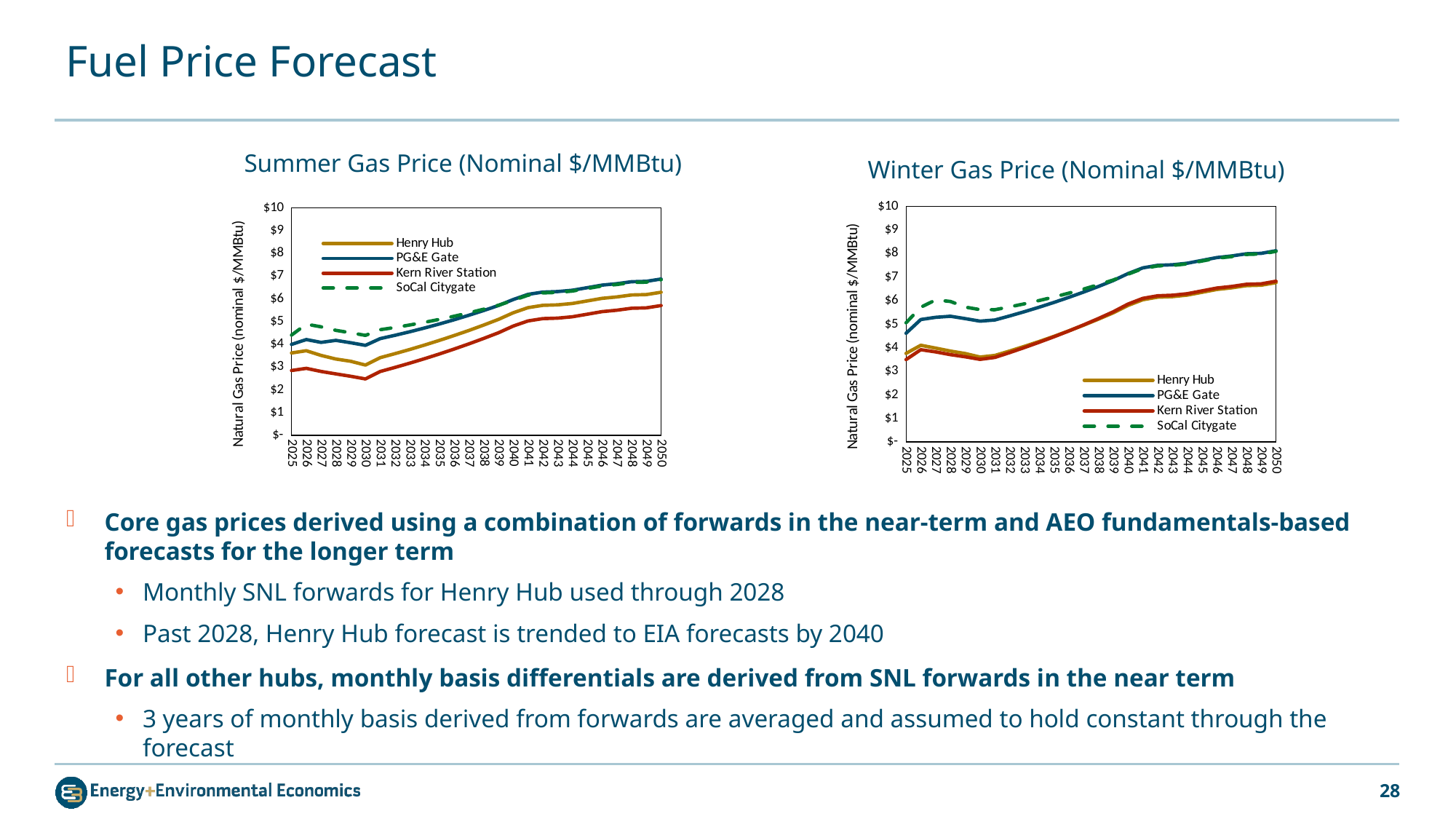
In the Winter Gas Price chart, which series is drawn with a dashed line? SoCal Citygate In the Winter Gas Price chart, is the Kern River Station value in 2030 greater or less than $4? less In the Summer Gas Price chart, is the PG&E Gate value in 2050 greater or less than $6? greater How many series does the legend of the Winter Gas Price chart list? 4 In the Summer Gas Price chart, which series has the lowest values across the forecast period? Kern River Station In the Winter Gas Price chart, which series is highest in 2025? SoCal Citygate How many years are shown on the x axis of the Summer Gas Price chart? 26 What kind of chart is the Summer Gas Price chart? line chart In the Summer Gas Price chart, which is higher in 2050: PG&E Gate or Kern River Station? PG&E Gate In the Winter Gas Price chart, is the Henry Hub value in 2050 greater or less than $6? greater In the Summer Gas Price chart, do the prices generally rise or fall from 2025 to 2050? rise